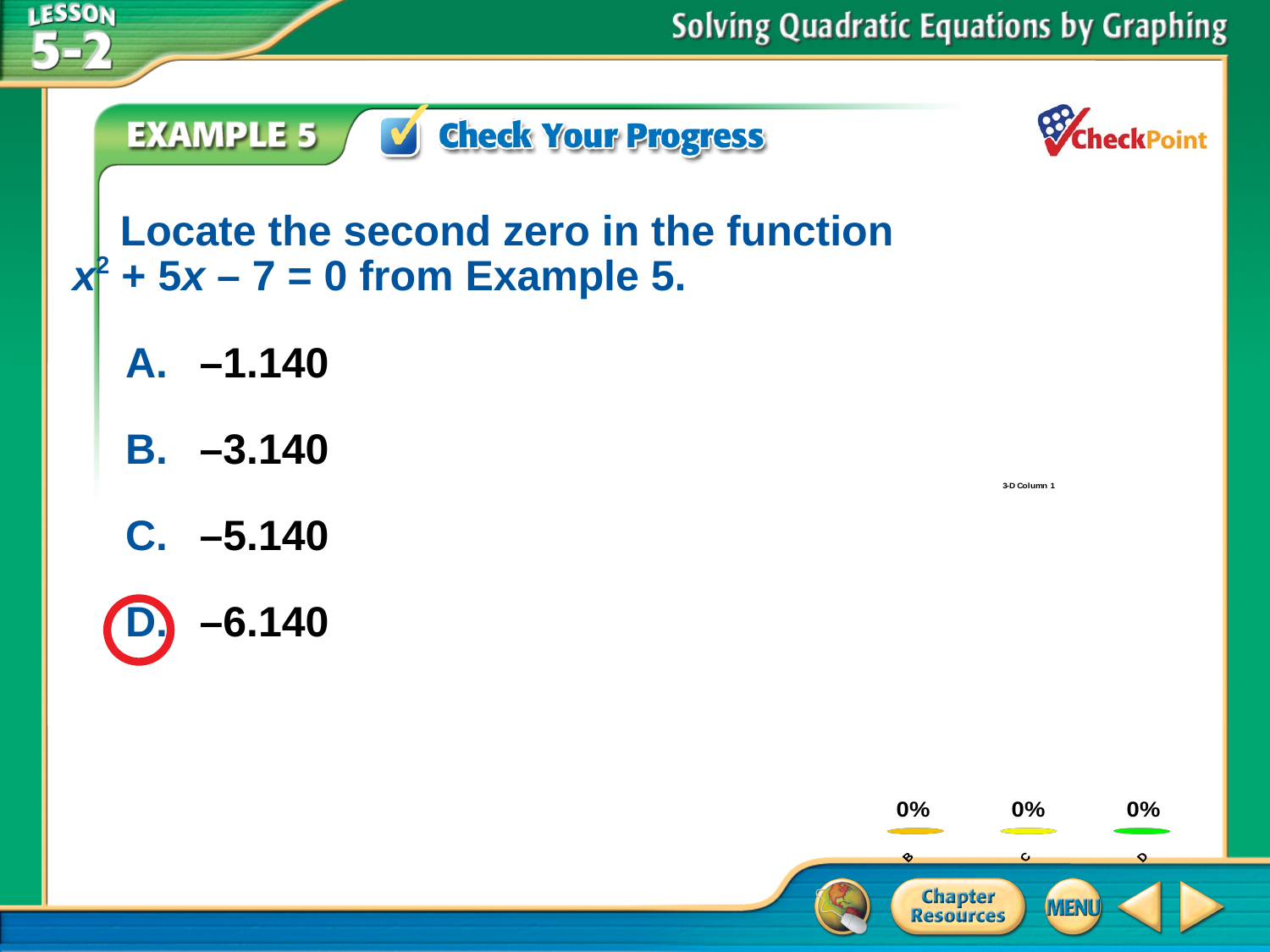
In the chart at the bottom right, is the value for category C greater than or equal to the value for category D? equal What value is shown for category B in the chart at the bottom right of the slide? 0% What value is shown for category C in the chart at the bottom right of the slide? 0% What value is shown for category D in the chart at the bottom right of the slide? 0% What kind of chart is shown at the bottom right of the slide? bar chart